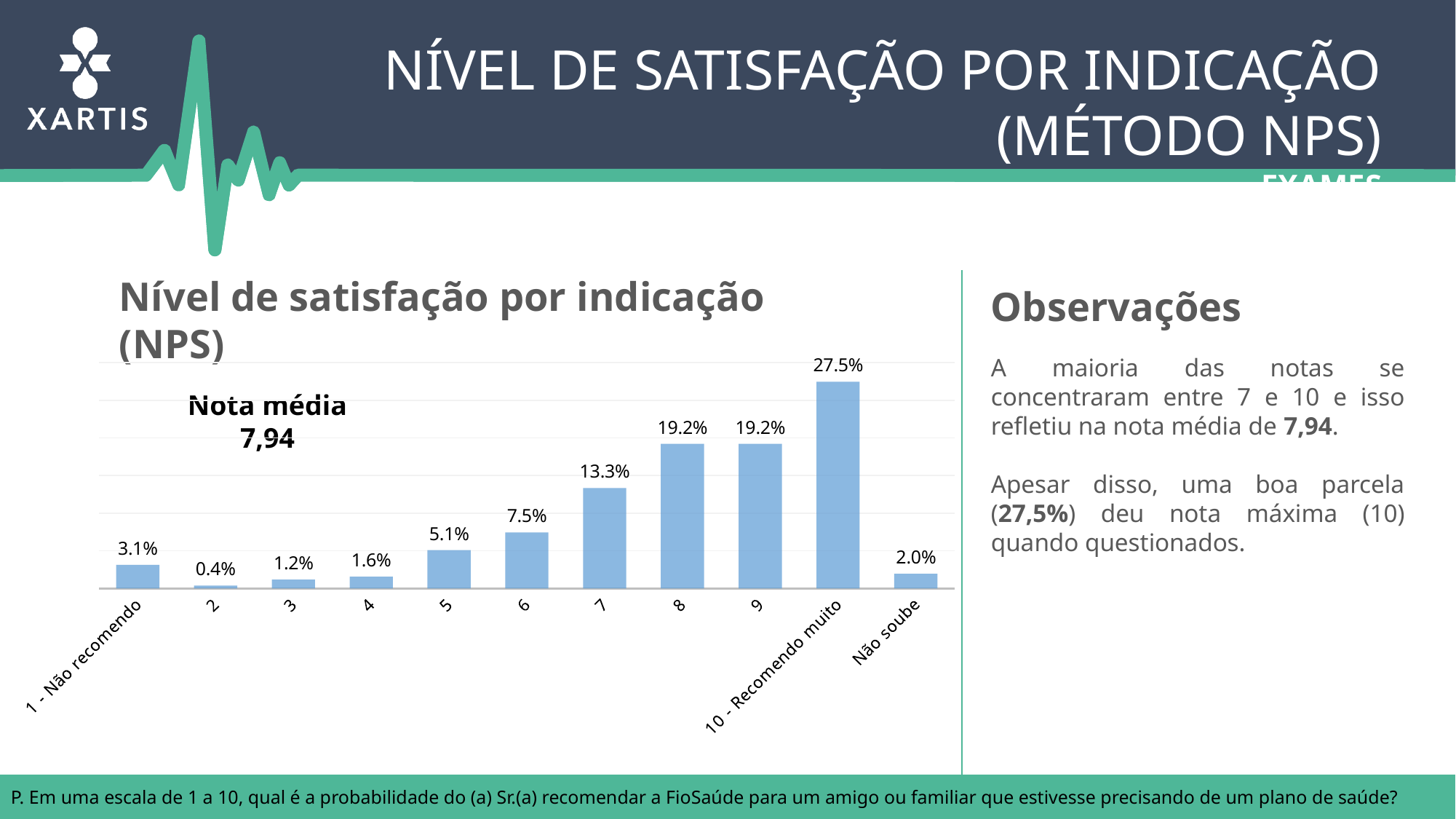
What is the difference between the values for category 10 and category 9? 8.3% What is the value for "10 - Recomendo muito"? 27.5% What kind of chart is shown on the slide? Bar chart What average score (Nota média) is printed on the chart? 7,94 Do the values rise or fall from category 2 to category 10? Rise Which category has the highest value? 10 - Recomendo muito Which is larger, the value for category 6 or the value for category 5? 6 What is the value for "Não soube"? 2.0% How many categories are shown on the x axis? 11 What is the value for category 7? 13.3% Which category has the lowest value? 2 What is the value for "1 - Não recomendo"? 3.1%